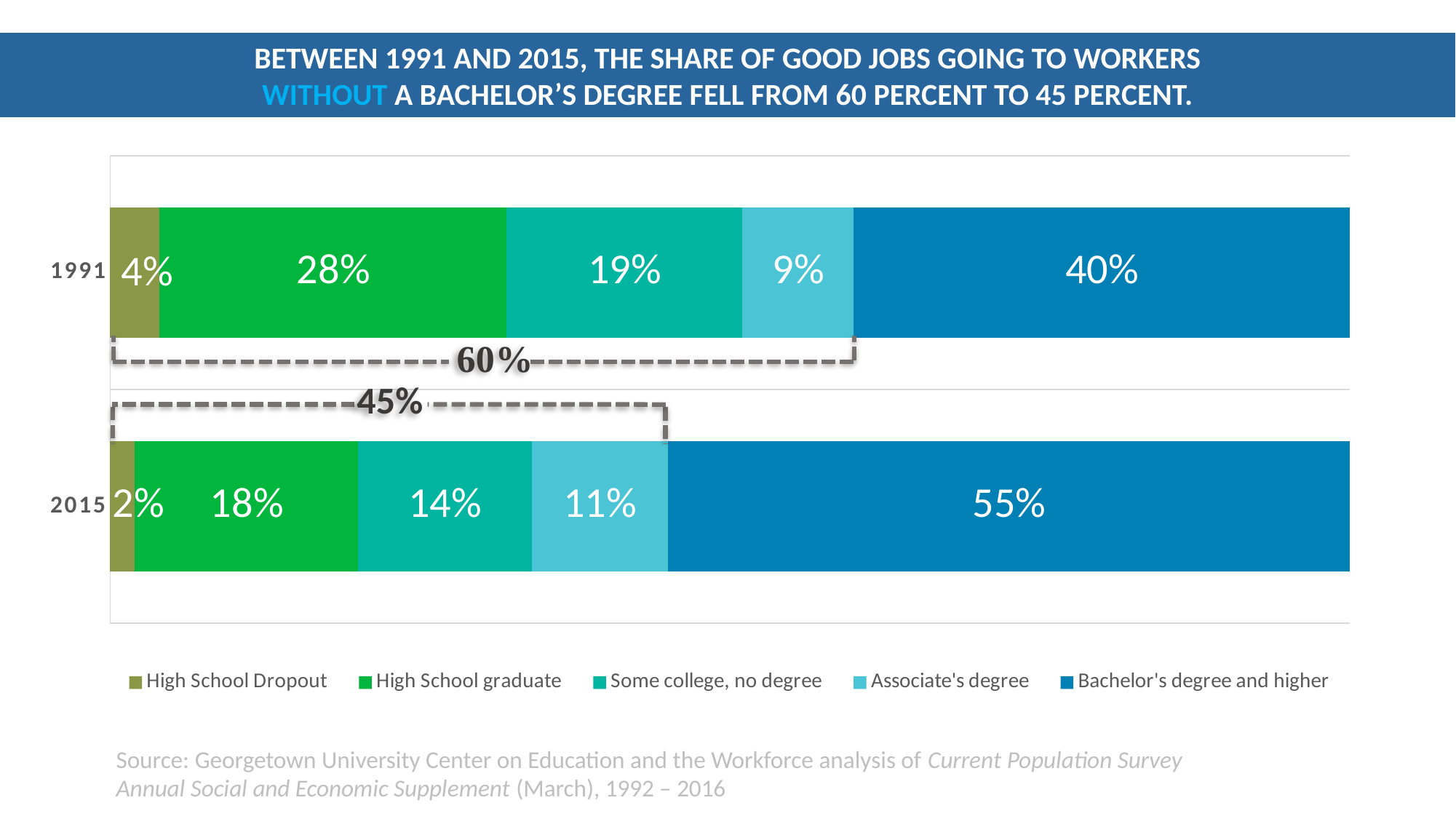
Which education category had the smallest share of good jobs in 2015? High School Dropout How many years (bars) are shown in the chart? 2 How many series does the legend list? 5 What share of good jobs went to High School Dropouts in 1991? 4% By how many percentage points did the share for Bachelor's degree and higher change from 1991 to 2015? 15 What is the combined share of good jobs going to workers without a bachelor's degree in 2015, as marked on the chart? 45% Which education category had the largest share of good jobs in 1991? Bachelor's degree and higher What share of good jobs went to High School graduates in 1991? 28% What share of good jobs went to workers with a Bachelor's degree and higher in 2015? 55% What share of good jobs went to workers with an Associate's degree in 2015? 11% What kind of chart is shown on the slide? Stacked bar chart Which is larger: the share for Some college, no degree in 1991 or in 2015? 1991